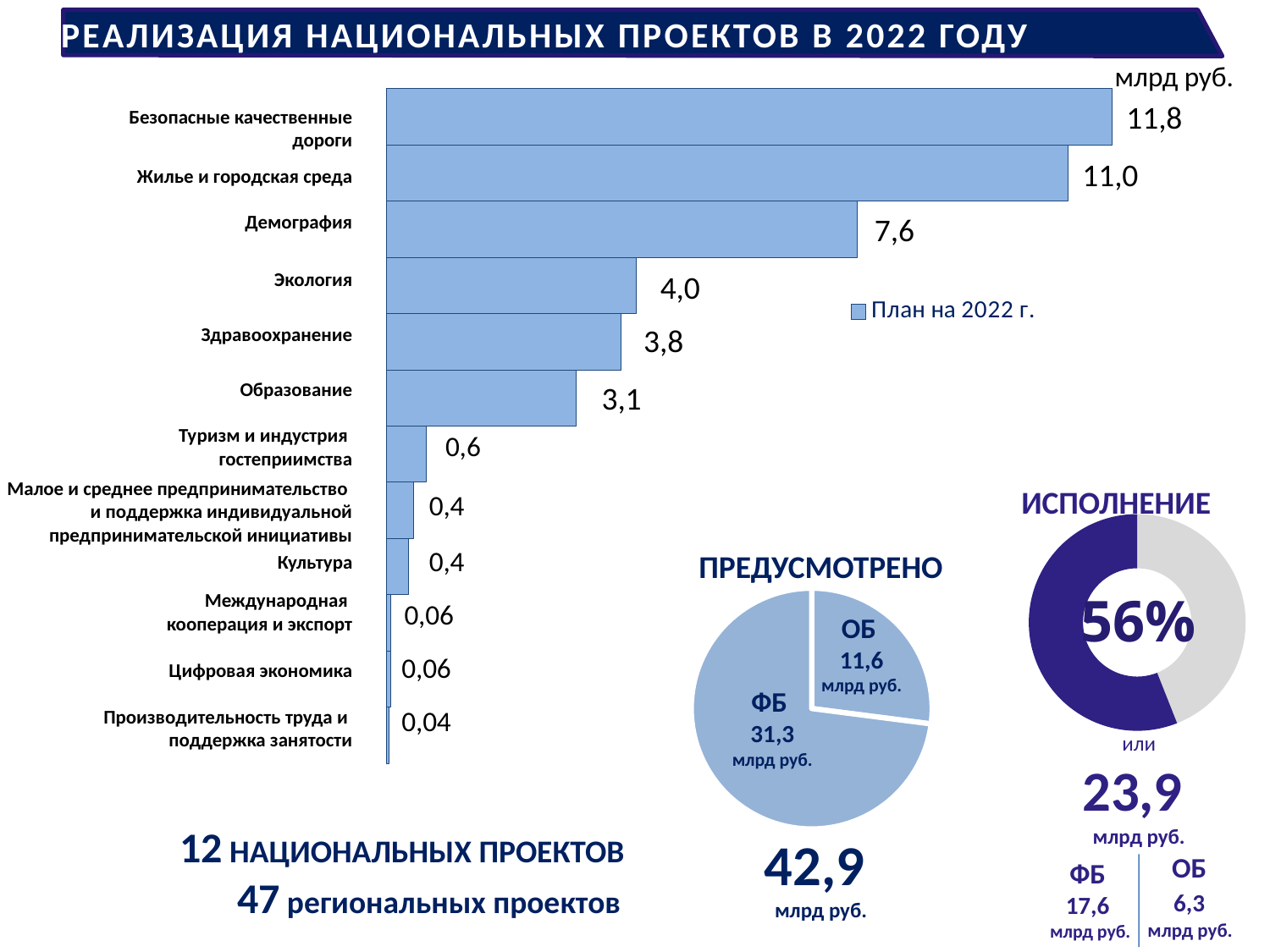
What type of chart is used to show the plan for 2022 by national project? Bar chart In the pie chart titled ПРЕДУСМОТРЕНО, what is the value for ФБ? 31,3 млрд руб. In the bar chart, which has a larger planned value: Здравоохранение or Образование? Здравоохранение In the bar chart, what is the planned value for 2022 for Безопасные качественные дороги? 11,8 How many national projects (categories) are shown in the bar chart? 12 In the bar chart, what is the difference between the planned values for Жилье и городская среда and Экология? 7,0 In the bar chart, what is the planned value for 2022 for Демография? 7,6 In the pie chart titled ПРЕДУСМОТРЕНО, what is the total of ФБ and ОБ? 42,9 млрд руб. In the bar chart, which national project has the lowest planned value for 2022? Производительность труда и поддержка занятости How many series does the legend of the bar chart list? 1 What percentage is shown in the donut chart titled ИСПОЛНЕНИЕ? 56% In the bar chart, which national project has the highest planned value for 2022? Безопасные качественные дороги